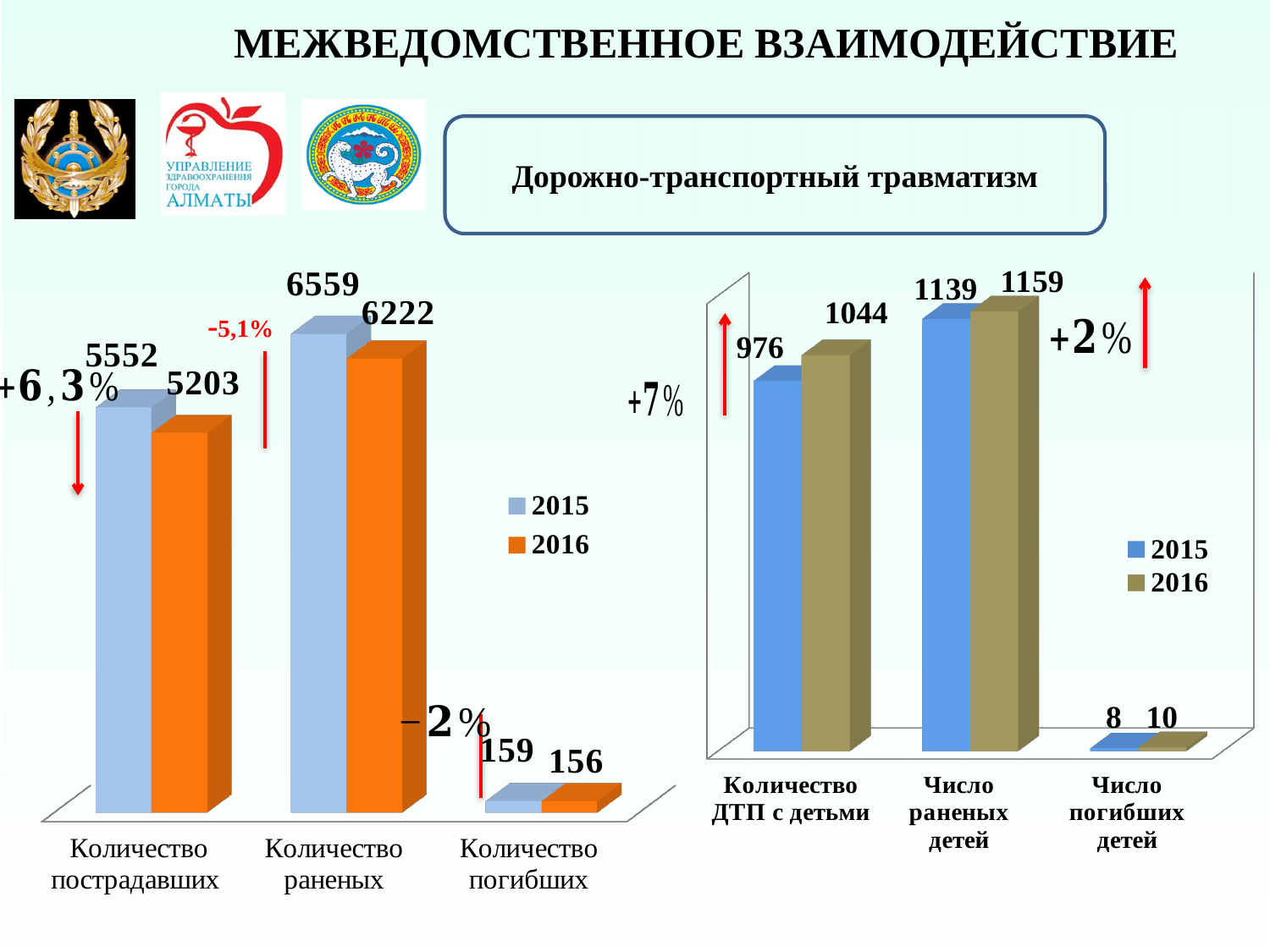
In the left chart, what is the 2015 value for Количество пострадавших? 5552 In the right chart, which category has the lowest 2016 value? Число погибших детей In the left chart, which category has the highest 2015 value? Количество раненых In the left chart, how many series does the legend list? 2 What kind of chart is the right chart? bar chart In the right chart, what is the 2015 value for Число погибших детей? 8 In the left chart, what is the difference between the 2015 and 2016 values for Количество пострадавших? 349 In the right chart, is the 2016 value for Число раненых детей larger or smaller than the 2015 value? larger In the right chart, what is the 2016 value for Количество ДТП с детьми? 1044 In the left chart, what is the 2016 value for Количество раненых? 6222 In the right chart, what is the difference between the 2016 and 2015 values for Количество ДТП с детьми? 68 In the left chart, what is the 2016 value for Количество погибших? 156